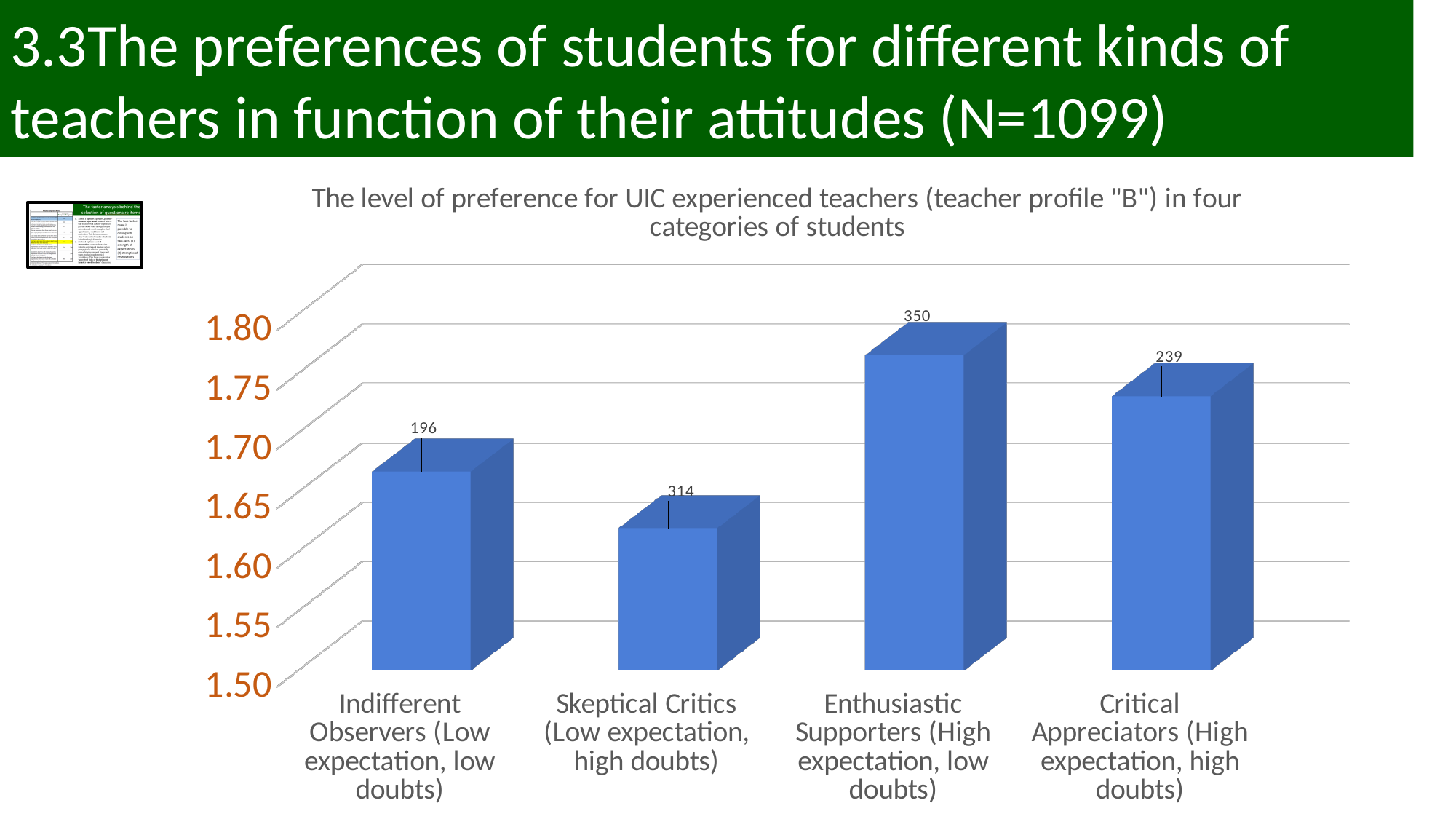
What kind of chart is shown on the slide? bar chart Which category of students has the highest bar in the chart? Enthusiastic Supporters (High expectation, low doubts) Which bar is taller, Critical Appreciators or Indifferent Observers? Critical Appreciators What number is printed above the bar for Indifferent Observers? 196 What number is printed above the bar for Skeptical Critics? 314 How many categories of students are shown on the x axis of the chart? 4 What is the title of the chart? The level of preference for UIC experienced teachers (teacher profile "B") in four categories of students Which category of students has the lowest bar in the chart? Skeptical Critics (Low expectation, high doubts) What number is printed above the bar for Critical Appreciators? 239 Is the bar for Enthusiastic Supporters greater or less than 1.75 on the vertical axis? greater What number is printed above the bar for Enthusiastic Supporters? 350 Is the bar for Skeptical Critics greater or less than 1.65 on the vertical axis? less